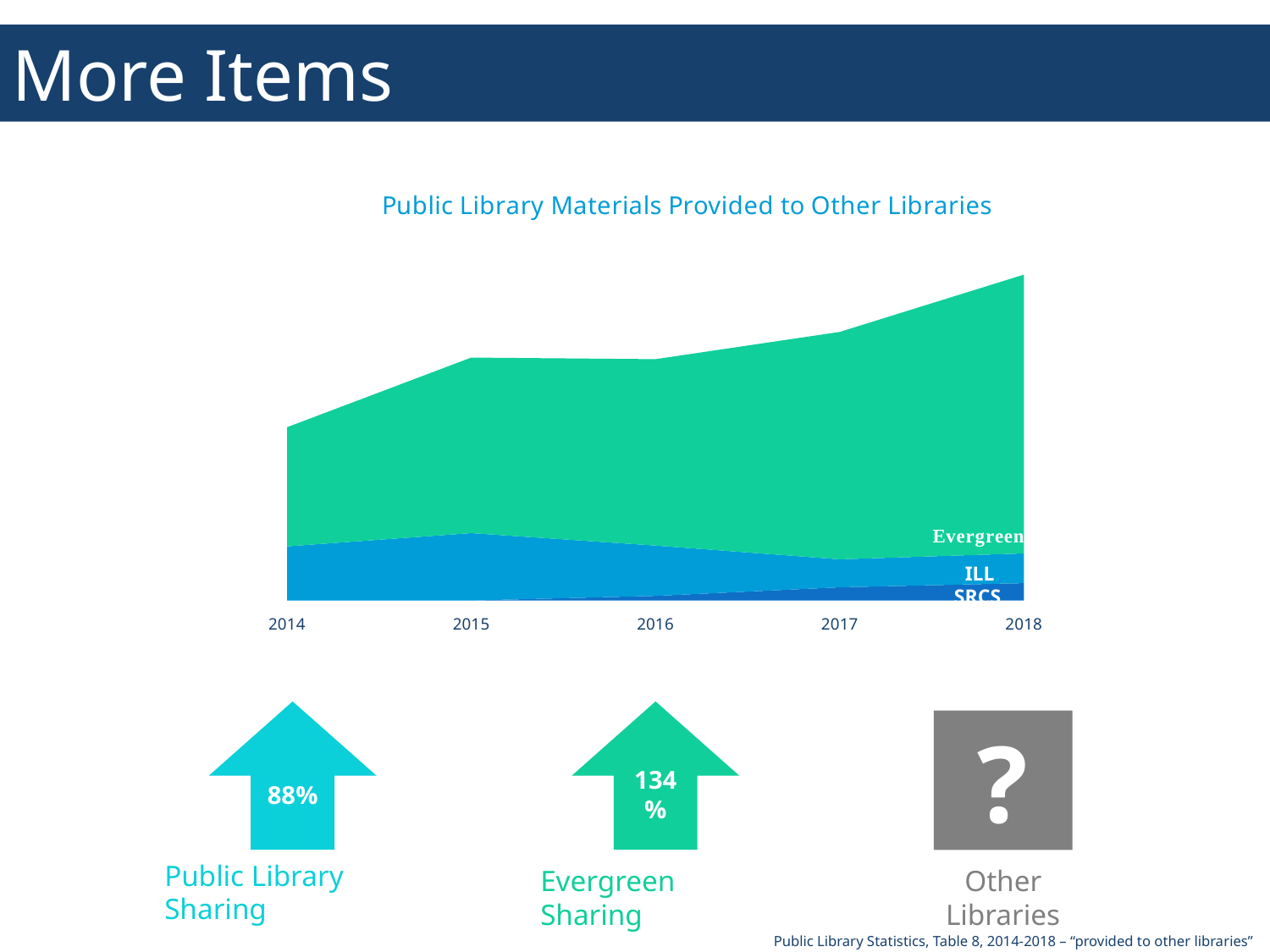
Does the Evergreen series rise or fall from 2014 to 2018? Rise How many series are labelled on the chart? 3 What colour is the Evergreen series on the chart? Green What kind of chart is shown on the slide? Stacked area chart In 2018, which is larger, the Evergreen band or the ILL band? Evergreen What is the title of the chart? Public Library Materials Provided to Other Libraries How many years are shown along the x axis of the chart? 5 Does the total stacked value rise or fall from 2014 to 2018? Rise What is the first year shown on the x axis? 2014 Which series occupies the smallest area of the chart? SRCS Which series occupies the largest area of the chart? Evergreen Does the ILL band get thicker or thinner between 2016 and 2018? Thinner